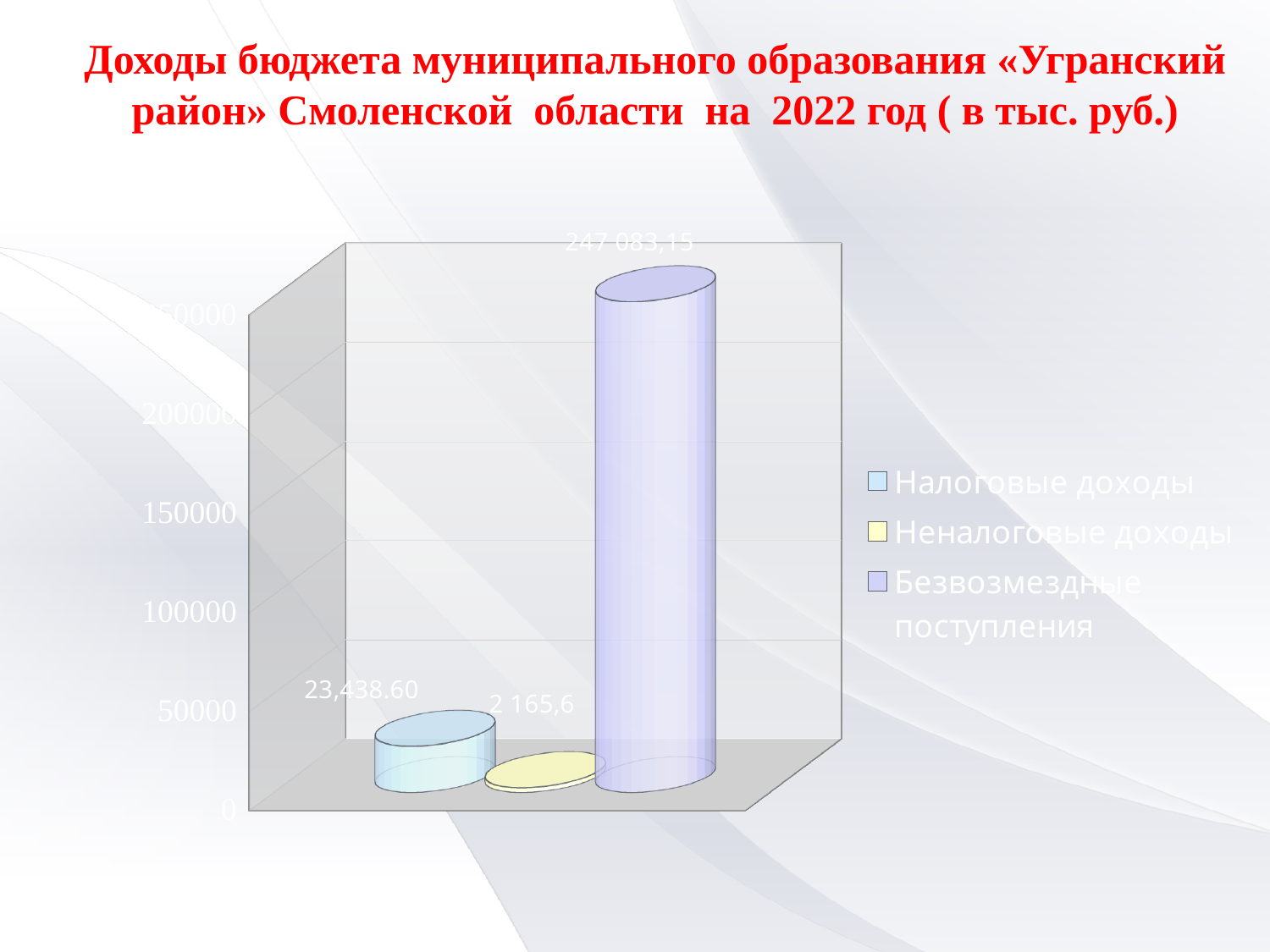
What is the value shown for Безвозмездные поступления? 247 083,15 What is the value shown for Налоговые доходы? 23,438.60 Which is larger, Налоговые доходы or Неналоговые доходы? Налоговые доходы What is the value shown for Неналоговые доходы? 2 165,6 How many series does the legend list? 3 Which series has the lowest value? Неналоговые доходы What is the highest value labelled on the vertical axis? 250000 Which series has the highest value? Безвозмездные поступления What kind of chart is shown on the slide? Bar chart Is the value for Безвозмездные поступления greater or less than 200000? greater What is the difference between Налоговые доходы and Неналоговые доходы? 21 273,0 Is the value for Налоговые доходы greater or less than 50000? less